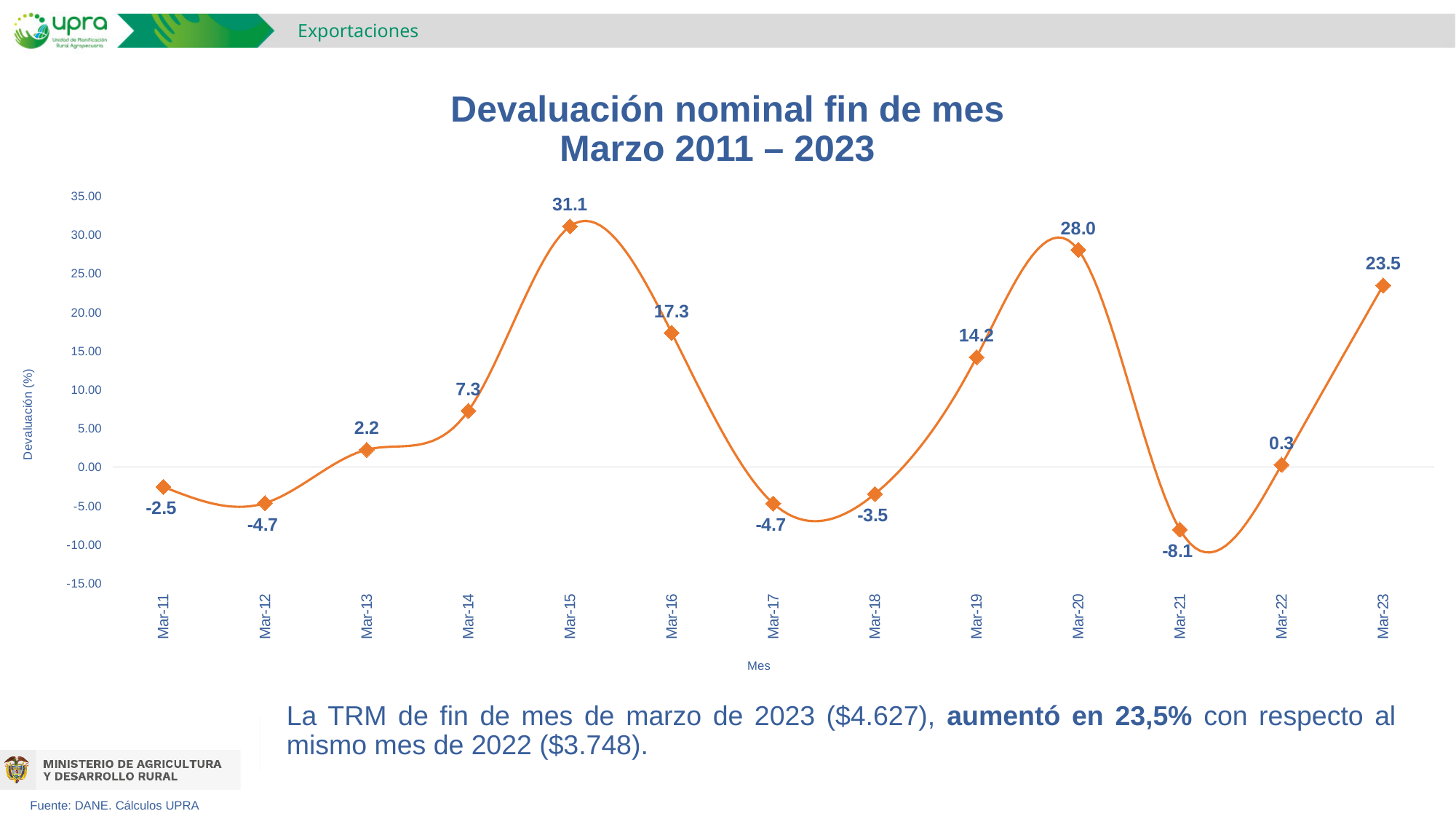
Which is larger, the value for Mar-16 or the value for Mar-19? Mar-16 What is the value for Mar-21? -8.1 Which month has the highest value? Mar-15 Which month has the lowest value? Mar-21 What is the difference between the values for Mar-20 and Mar-19? 13.8 What kind of chart is shown on the slide? line chart Do the values rise or fall from Mar-21 to Mar-23? rise How many data points are plotted on the chart? 13 What is the label of the y axis? Devaluación (%) What is the value for Mar-15? 31.1 Is the value for Mar-14 greater or less than 5.00? greater What is the value for Mar-23? 23.5